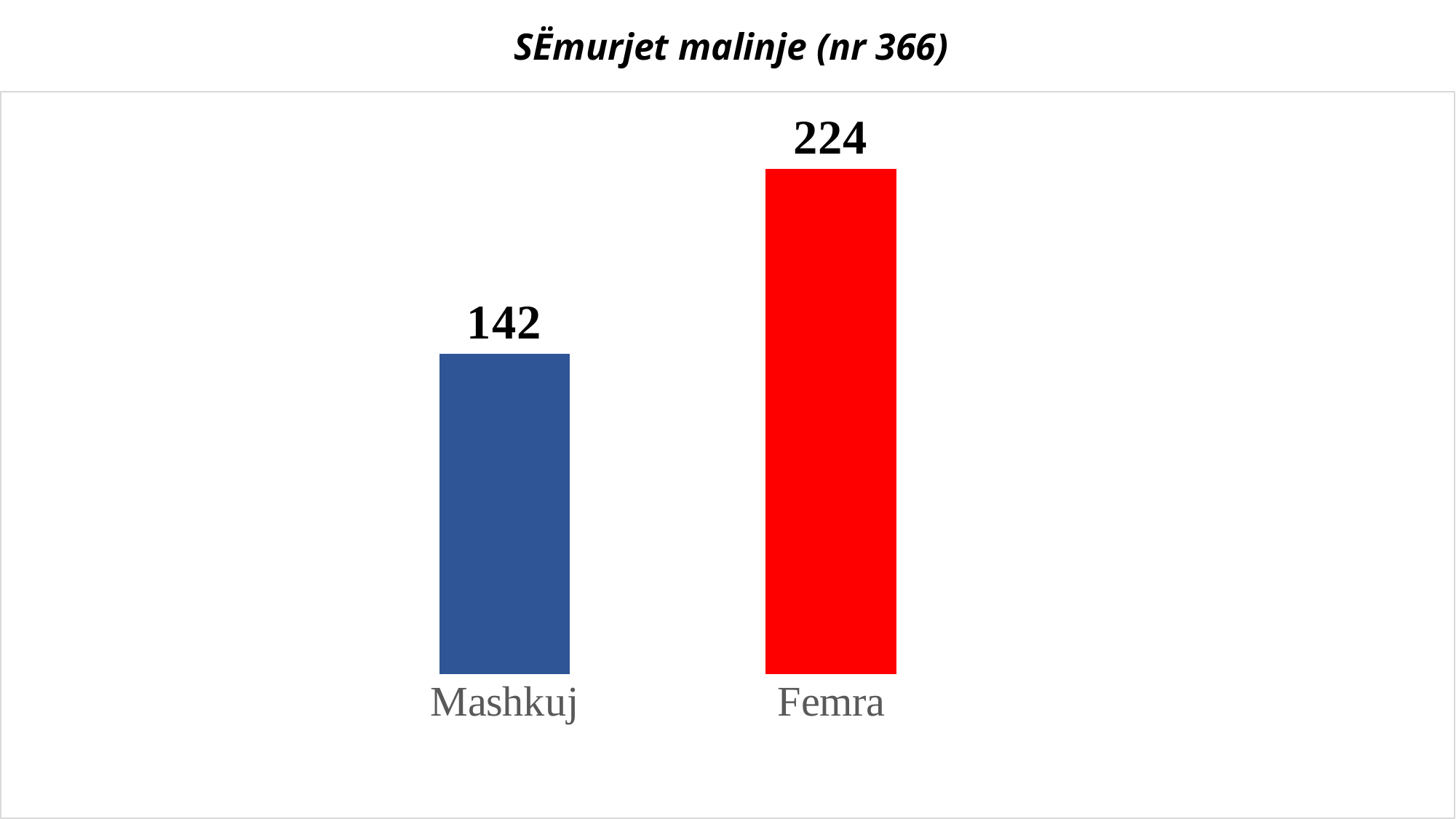
Which is larger, the value for Mashkuj or the value for Femra? Femra What is the title of the chart? SËmurjet malinje (nr 366) How many categories are shown in the chart? 2 What is the difference between the values for Femra and Mashkuj? 82 Which category has the highest value? Femra What kind of chart is shown on the slide? Bar chart What colour is the bar for Femra? Red What is the value for Mashkuj? 142 Which category has the lowest value? Mashkuj What is the value for Femra? 224 What is the total of the two values shown in the chart? 366